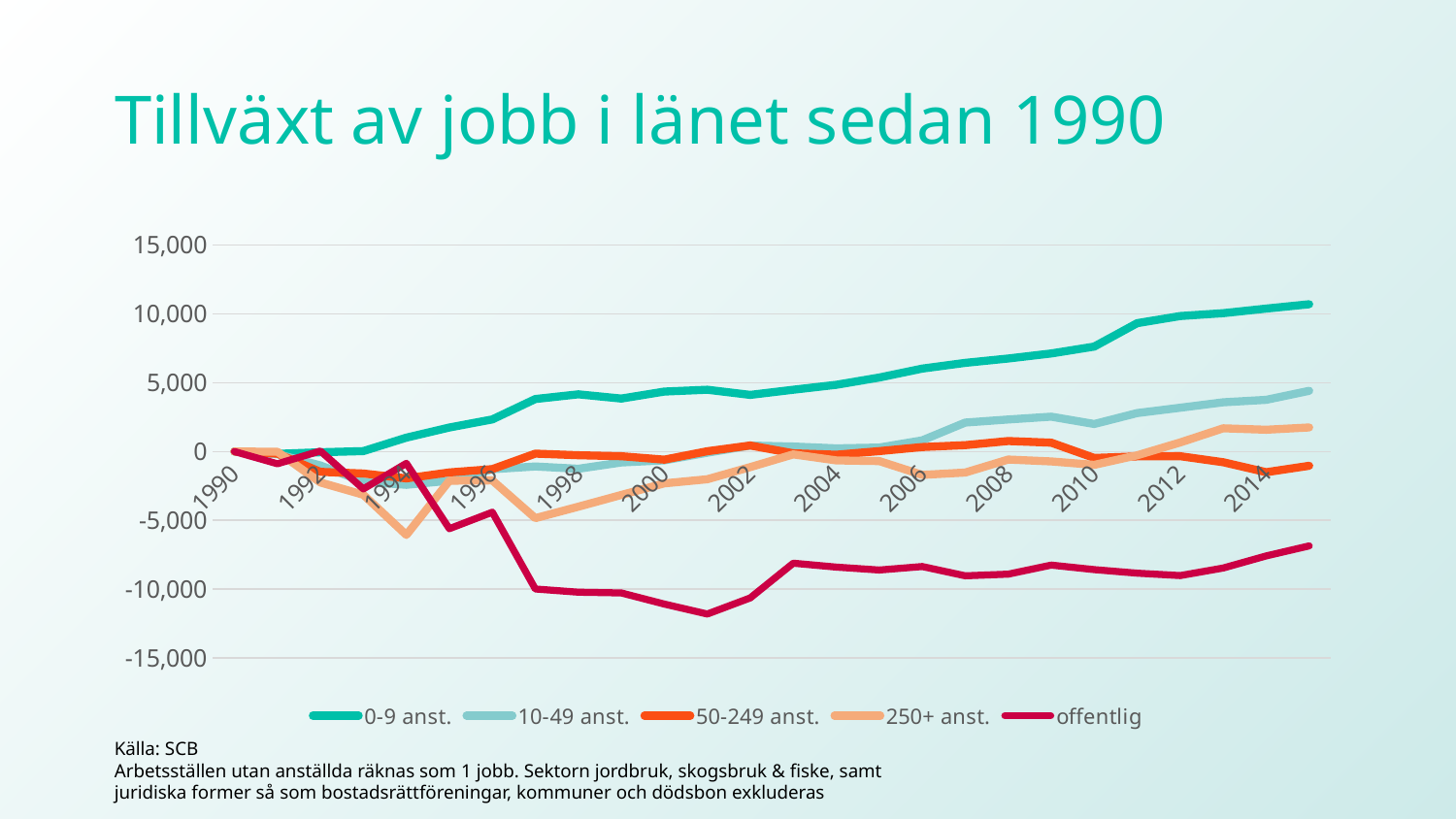
Is the value for offentlig in 2004 greater or less than -10,000? greater Does the 0-9 anst. series generally rise or fall from 1990 to 2014? rise In 2014, which is larger: the value for 0-9 anst. or the value for 10-49 anst.? 0-9 anst. Is the value for 10-49 anst. in 2014 greater or less than 5,000? less Is the value for 0-9 anst. in 2010 greater or less than 10,000? less Which series is shown in dark red/magenta in the legend? offentlig Which series has the highest value in 2014? 0-9 anst. What kind of chart is shown on the slide? line chart What is the title of the chart? Tillväxt av jobb i länet sedan 1990 Which series has the lowest value in 2014? offentlig How many series does the legend list? 5